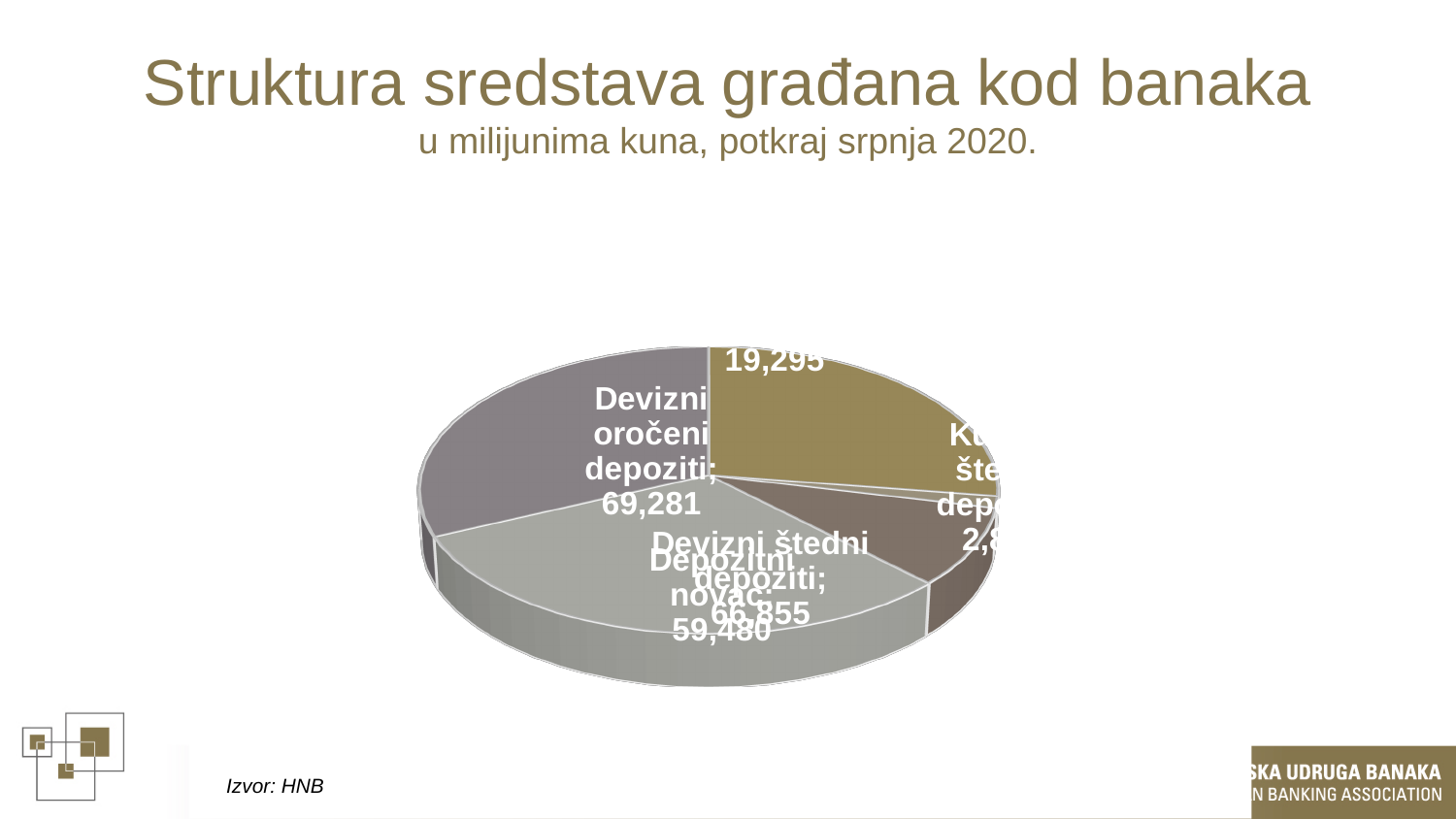
What is the title of the chart on the slide? Struktura sredstava građana kod banaka In what units and for what date are the values shown, according to the subtitle? u milijunima kuna, potkraj srpnja 2020. What is the value for Devizni štedni depoziti? 66,855 What is the value for Depozitni novac? 59,480 Which category has the highest value in the pie chart? Devizni oročeni depoziti What kind of chart is shown on the slide? pie chart What is the difference between Devizni oročeni depoziti and Depozitni novac? 9,801 Which is larger, Devizni oročeni depoziti or Depozitni novac? Devizni oročeni depoziti How many slices does the pie chart have? 5 What is the value for Devizni oročeni depoziti? 69,281 What is the difference between Devizni štedni depoziti and Depozitni novac? 7,375